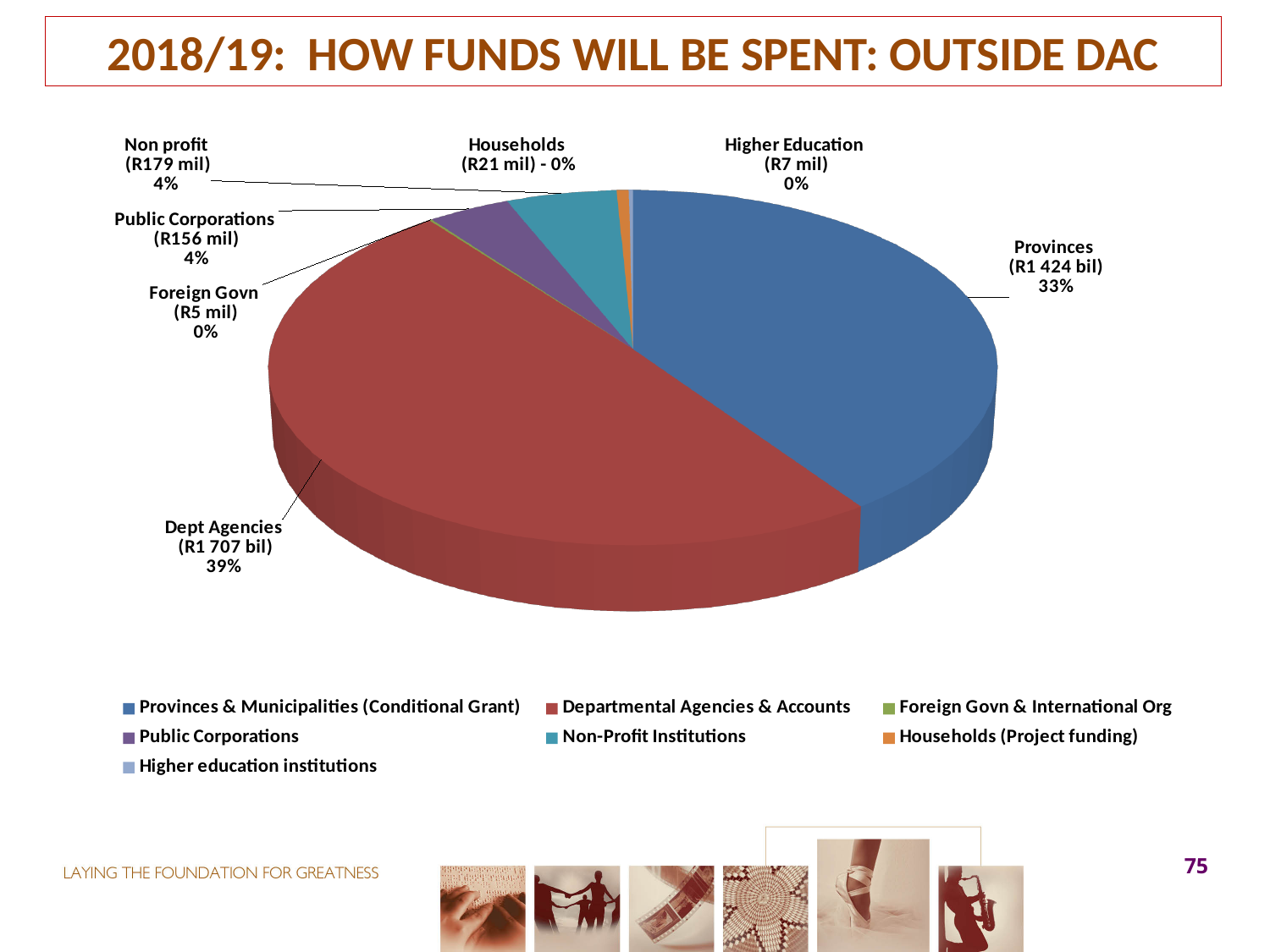
What share of the pie does Provinces represent? 33% What amount is shown for Households? R21 mil What is the difference in percentage points between the Dept Agencies share and the Provinces share? 6% What amount is shown for Non profit? R179 mil What amount is shown for Public Corporations? R156 mil What share of the pie does Dept Agencies represent? 39% Which category has the largest slice of the pie? Dept Agencies Which is larger, the share for Provinces or the share for Dept Agencies? Dept Agencies How many entries does the legend list? 7 What amount is shown for Foreign Govn? R5 mil What kind of chart is shown on the slide? pie chart Which category has the smallest amount shown? Foreign Govn